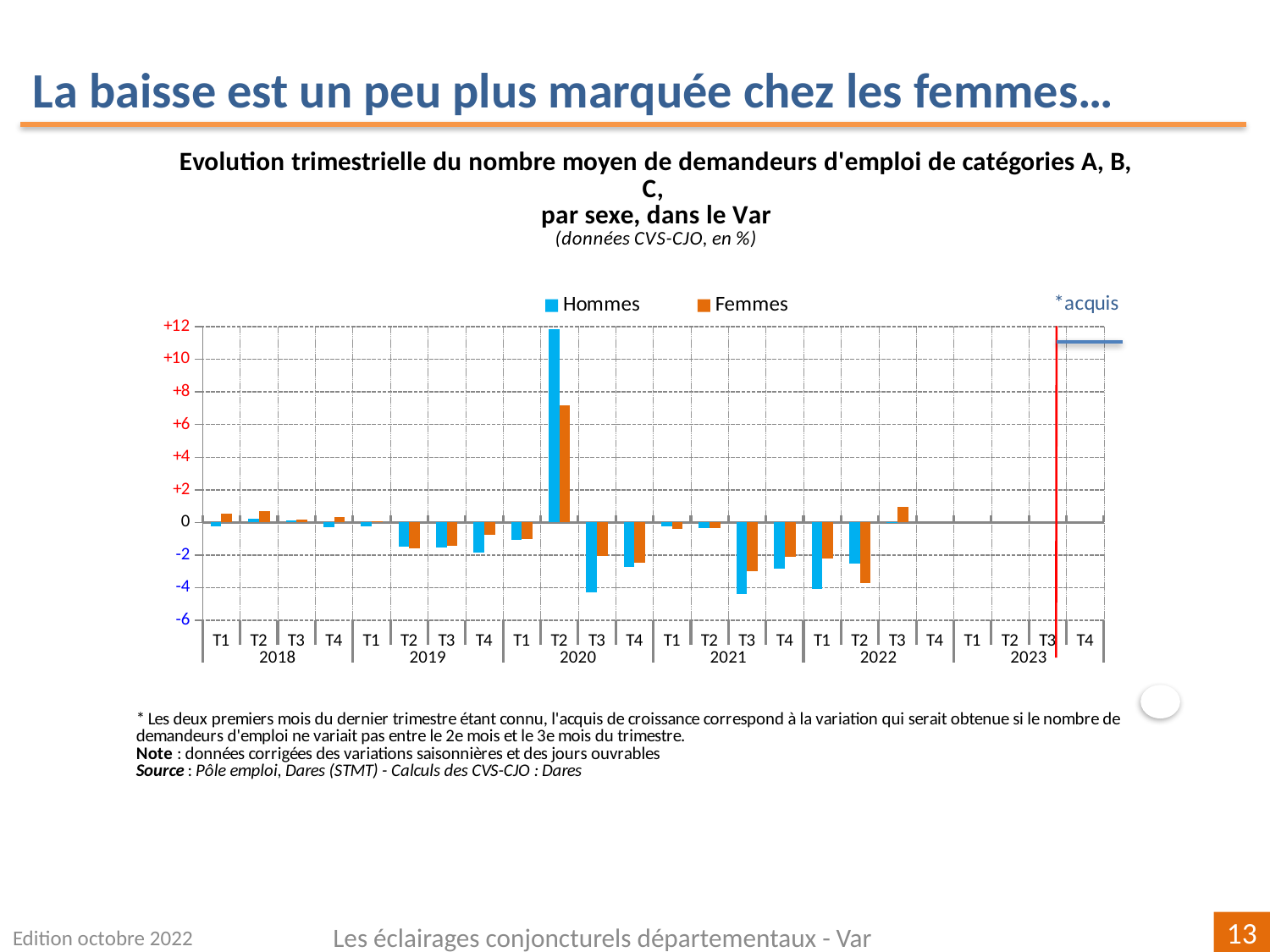
In T2 2020, which series has the larger value, Hommes or Femmes? Hommes Is the value for Hommes in T2 2020 greater or less than +10? greater How many years are shown along the x axis? 6 What kind of chart is shown on the slide? bar chart Is the value for Femmes in T2 2022 greater or less than -2? less What are the two series named in the legend? Hommes and Femmes What does the label next to the red vertical line on the right of the chart say? *acquis Is the value for Femmes in T2 2020 greater or less than +6? greater In T3 2020, which series has the lower value, Hommes or Femmes? Hommes Which quarter shows the highest value for Hommes? T2 2020 How many series does the legend list? 2